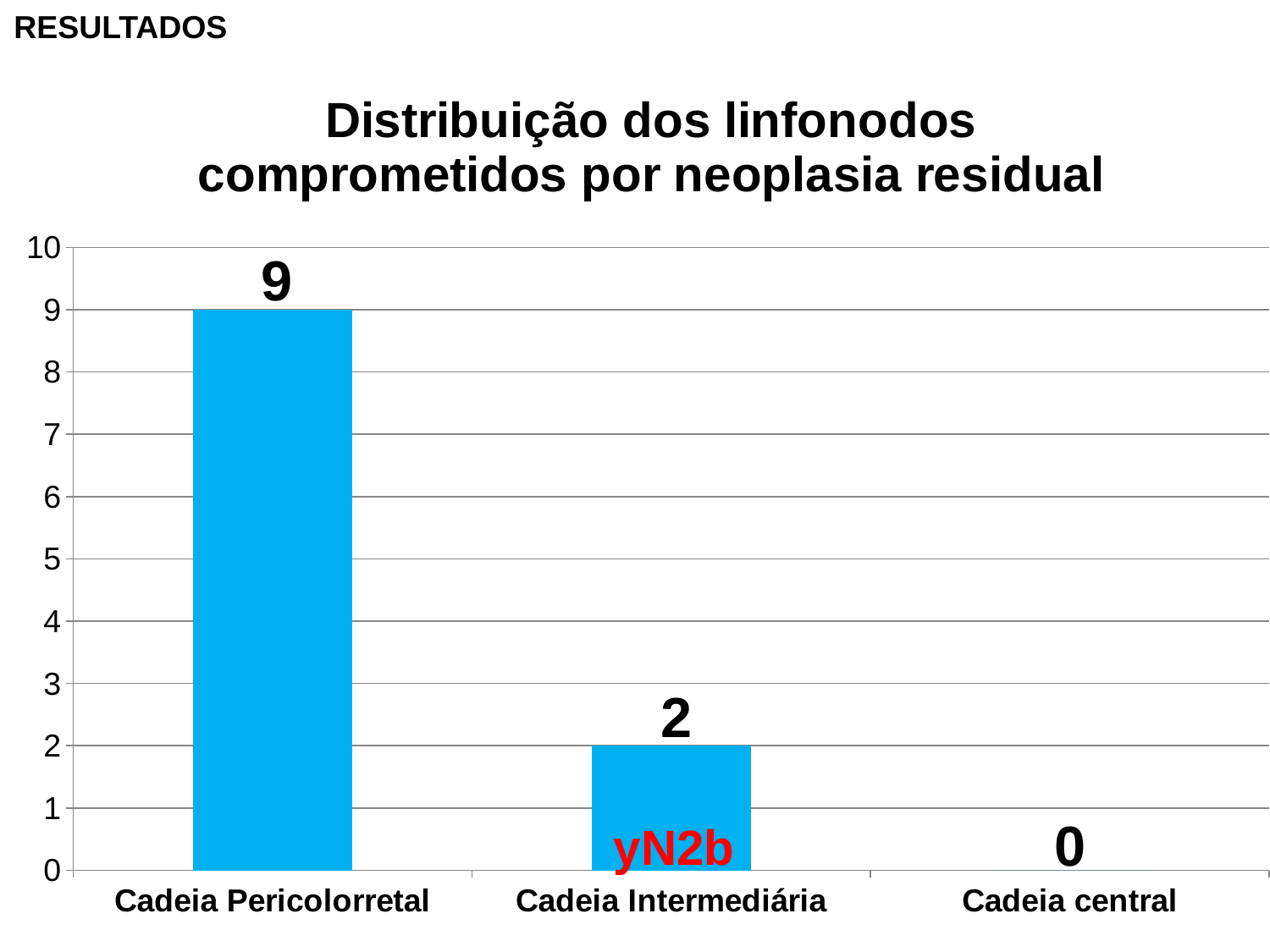
What is the value for Cadeia central? 0 Which is larger, the value for Cadeia Intermediária or the value for Cadeia central? Cadeia Intermediária What is the value for Cadeia Intermediária? 2 Do the values rise or fall from left to right along the x axis? fall Which category has the highest value? Cadeia Pericolorretal What is the difference between the values for Cadeia Pericolorretal and Cadeia Intermediária? 7 What is the value for Cadeia Pericolorretal? 9 Which category has the lowest value? Cadeia central What kind of chart is shown on the slide? bar chart Is the value for Cadeia Pericolorretal greater or less than 5? greater What is the title of the chart? Distribuição dos linfonodos comprometidos por neoplasia residual How many categories are shown on the x axis? 3